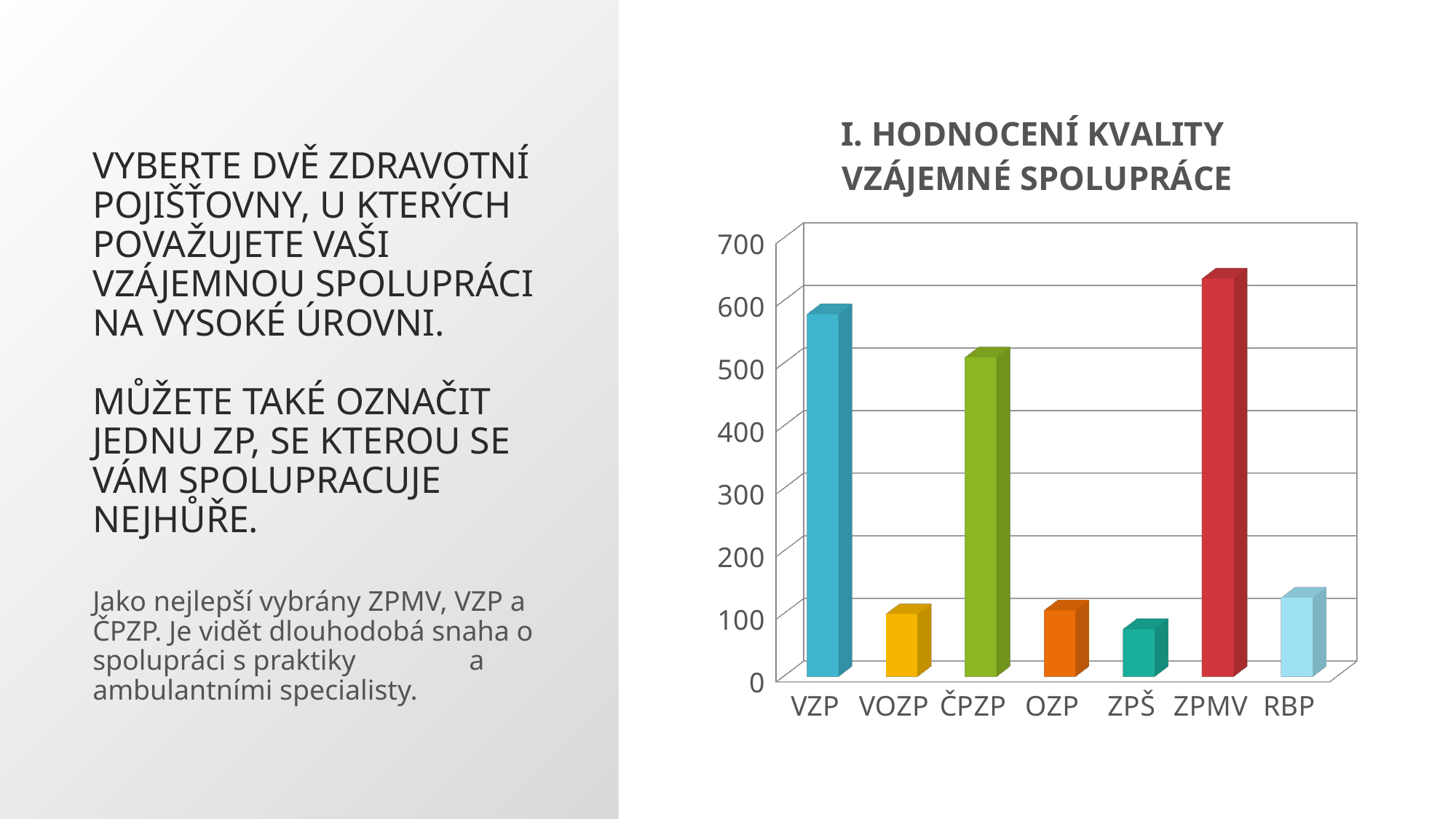
Which category has the highest value in the chart? ZPMV How many categories are shown on the x axis of the chart? 7 Which category has the lowest value in the chart? ZPŠ What is the title of the chart? I. HODNOCENÍ KVALITY VZÁJEMNÉ SPOLUPRÁCE Is the value for OZP greater or less than 200? less Is the value for ČPZP greater or less than 400? greater Which has a higher value, VZP or ČPZP? VZP What kind of chart is shown on the slide? Bar chart Is the value for VZP greater or less than 500? greater Which has a higher value, ZPMV or VZP? ZPMV